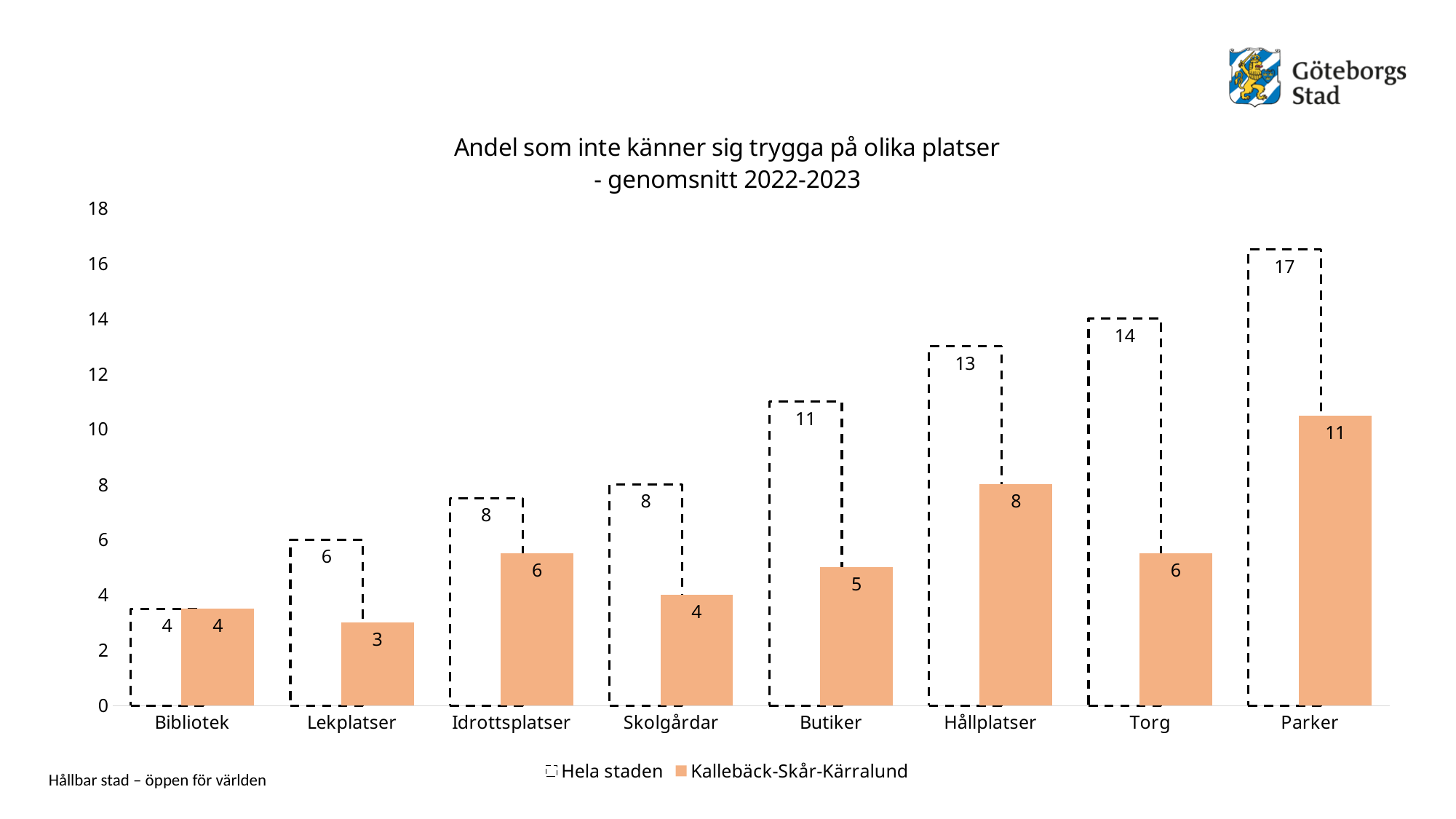
What is the value for Kallebäck-Skår-Kärralund at Hållplatser? 8 Which category has the highest value for Kallebäck-Skår-Kärralund? Parker What is the value for Hela staden at Parker? 17 What is the title of the chart? Andel som inte känner sig trygga på olika platser - genomsnitt 2022-2023 What kind of chart is shown on the slide? Bar chart How many categories are shown on the x axis? 8 What is the difference between Hela staden and Kallebäck-Skår-Kärralund at Torg? 8 How many series does the legend list? 2 Which category has the lowest value for Hela staden? Bibliotek What is the value for Hela staden at Butiker? 11 Which is larger at Skolgårdar: Hela staden or Kallebäck-Skår-Kärralund? Hela staden What is the value for Kallebäck-Skår-Kärralund at Lekplatser? 3